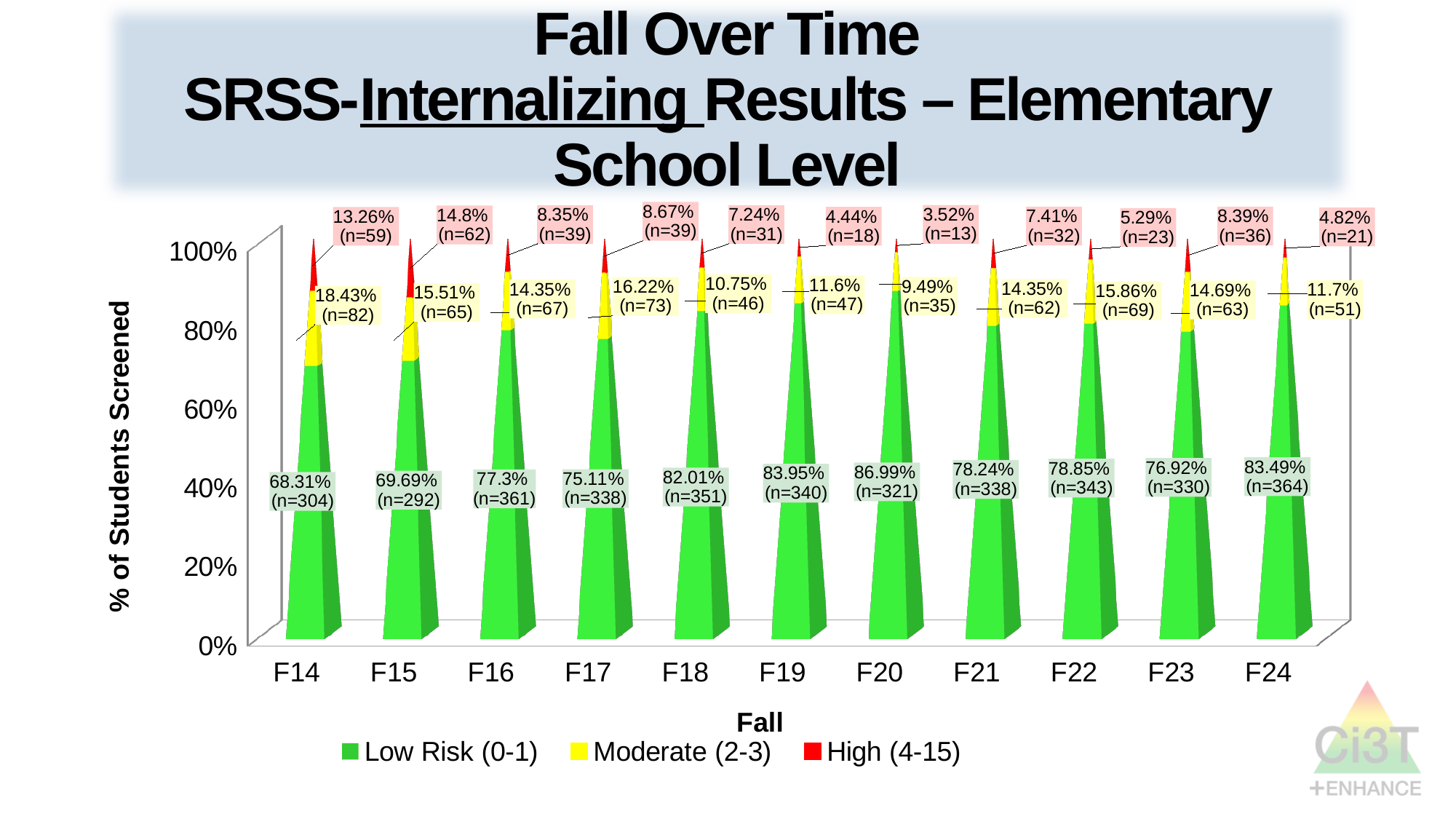
How many students were in the Low Risk (0-1) group in F24? n=364 Which fall has the highest Moderate (2-3) percentage? F14 How many fall time points are shown on the x axis? 11 What percentage of students screened were Moderate (2-3) in F17? 16.22% What percentage of students screened were Low Risk (0-1) in F20? 86.99% Which fall has the highest Low Risk (0-1) percentage? F20 What percentage of students screened were High (4-15) in F14? 13.26% Which is larger, the High (4-15) percentage in F15 or in F16? F15 How many series does the legend list? 3 What is the difference between the Low Risk (0-1) percentage in F20 and in F14? 18.68% Which fall has the lowest High (4-15) percentage? F20 What colour represents the High (4-15) series? Red